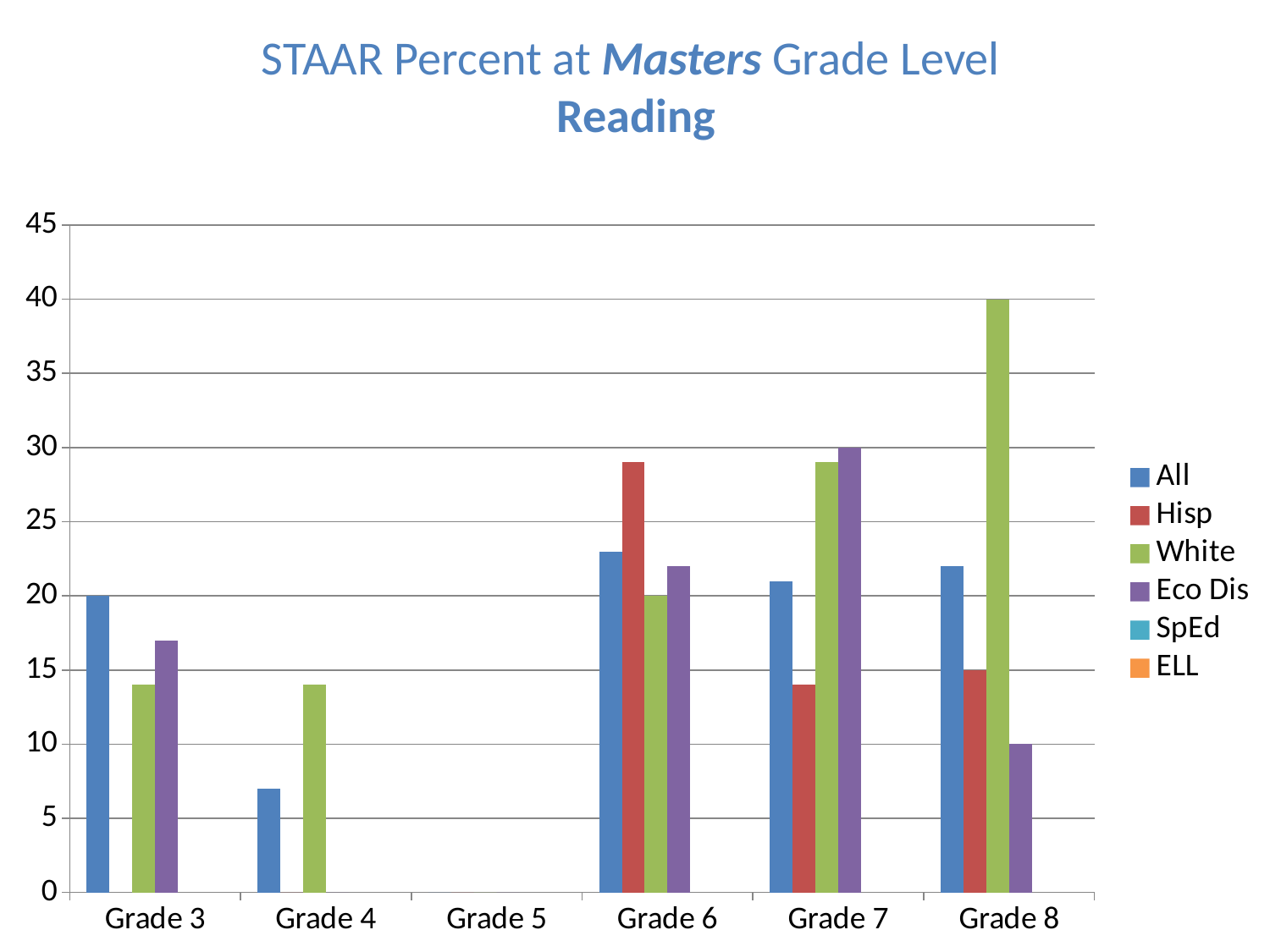
What kind of chart is shown on the slide? bar chart How many series does the legend list? 6 Is the value for All in Grade 4 greater or less than 10? less What is the value for White in Grade 8? 40 How many grade categories are shown on the x axis? 6 What is the value for All in Grade 3? 20 What is the value for Eco Dis in Grade 7? 30 What is the title of the chart? STAAR Percent at Masters Grade Level Reading Which is larger in Grade 8, the Hisp value or the Eco Dis value? Hisp What is the value for Eco Dis in Grade 8? 10 Which grade has the highest White value? Grade 8 Is the value for Hisp in Grade 6 greater or less than 25? greater